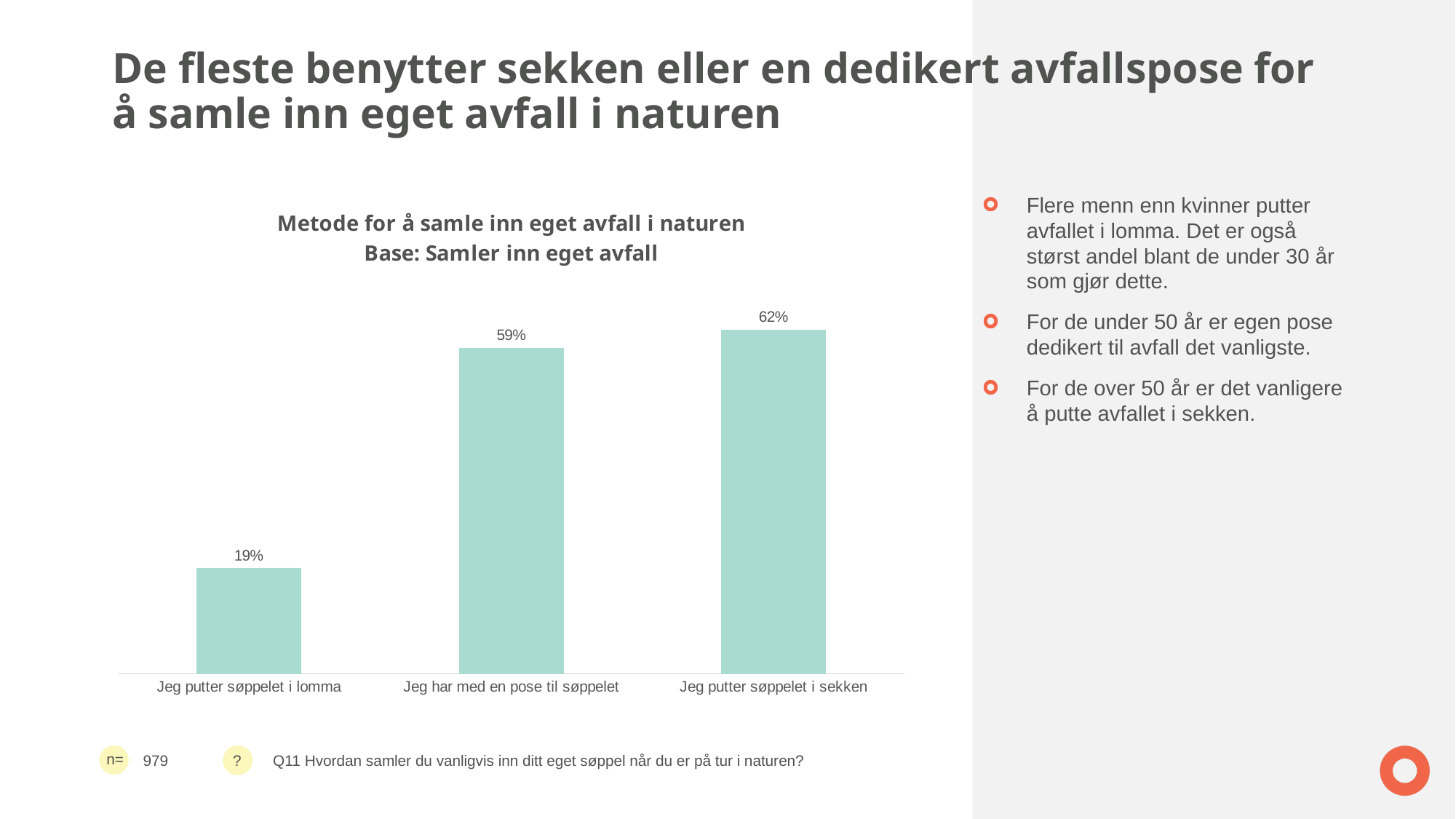
What is the value for "Jeg putter søppelet i lomma"? 19% What is the value for "Jeg har med en pose til søppelet"? 59% Which category has the highest value? Jeg putter søppelet i sekken What is the value for "Jeg putter søppelet i sekken"? 62% Which category has the lowest value? Jeg putter søppelet i lomma Which is larger: the value for "Jeg putter søppelet i lomma" or the value for "Jeg har med en pose til søppelet"? Jeg har med en pose til søppelet What kind of chart is shown on the slide? Bar chart How many categories are shown in the chart? 3 What is the difference between the values for "Jeg har med en pose til søppelet" and "Jeg putter søppelet i lomma"? 40% Do the values rise or fall from left to right along the x axis? Rise What is the title of the chart? Metode for å samle inn eget avfall i naturen Base: Samler inn eget avfall What is the difference between the values for "Jeg putter søppelet i sekken" and "Jeg har med en pose til søppelet"? 3%